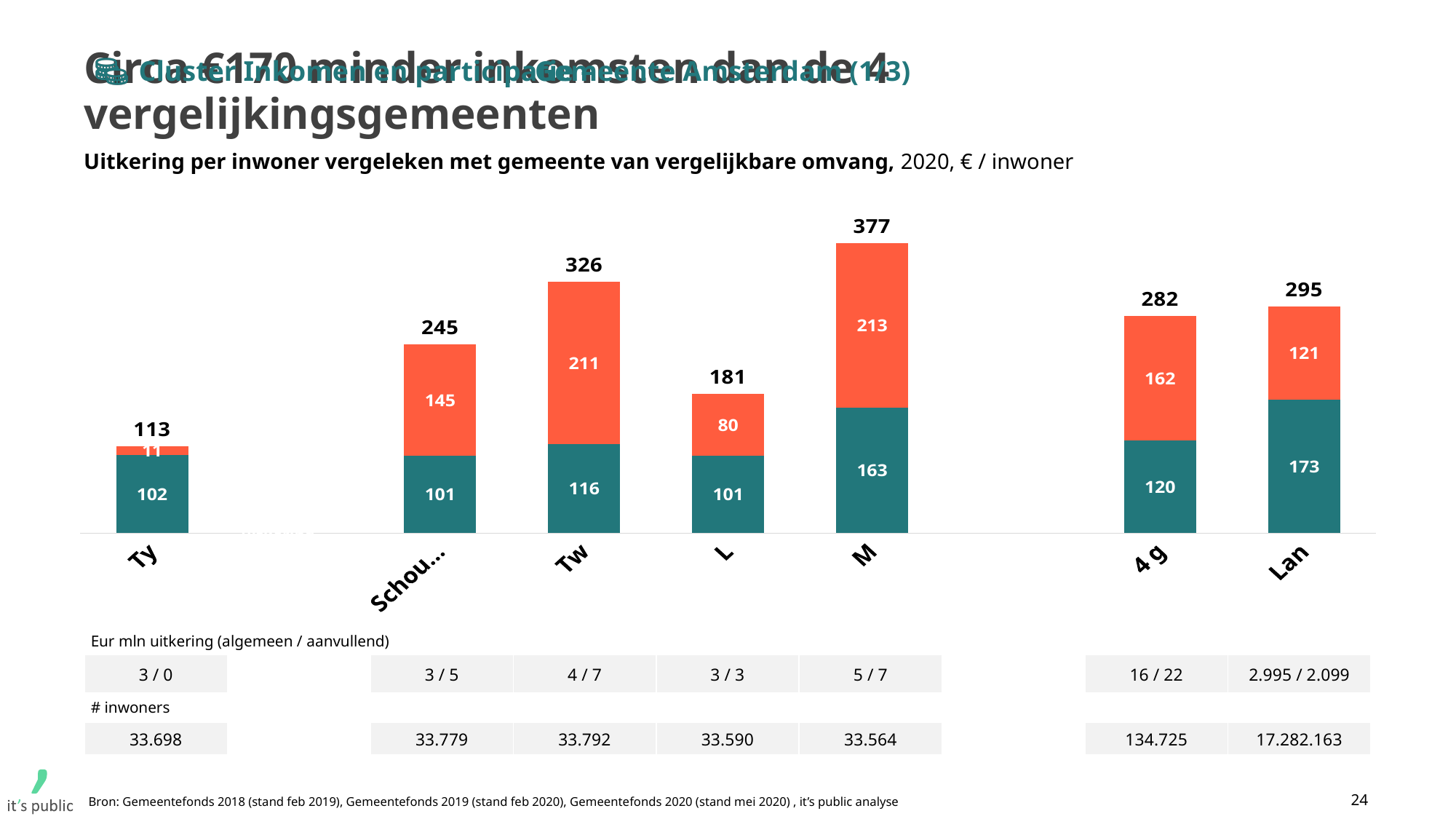
Which category has the highest total value? M What is the difference between the dark teal (bottom) segment of M and the dark teal segment of L? 62 What is the value of the orange (top) segment of the Ty bar? 11 What is the difference between the total for Lan and the total for 4 g? 13 What is the value of the dark teal (bottom) segment of the Tw bar? 116 What is the value of the orange (top) segment of the 4 g bar? 162 What is the total value shown above the bar for L? 181 What kind of chart is shown on the slide? Stacked bar chart What is the total value shown above the bar for M? 377 Which category has the lowest total value? Ty In what unit are the chart values expressed, according to the subtitle? € / inwoner Which has a larger total, Schou... or L? Schou...